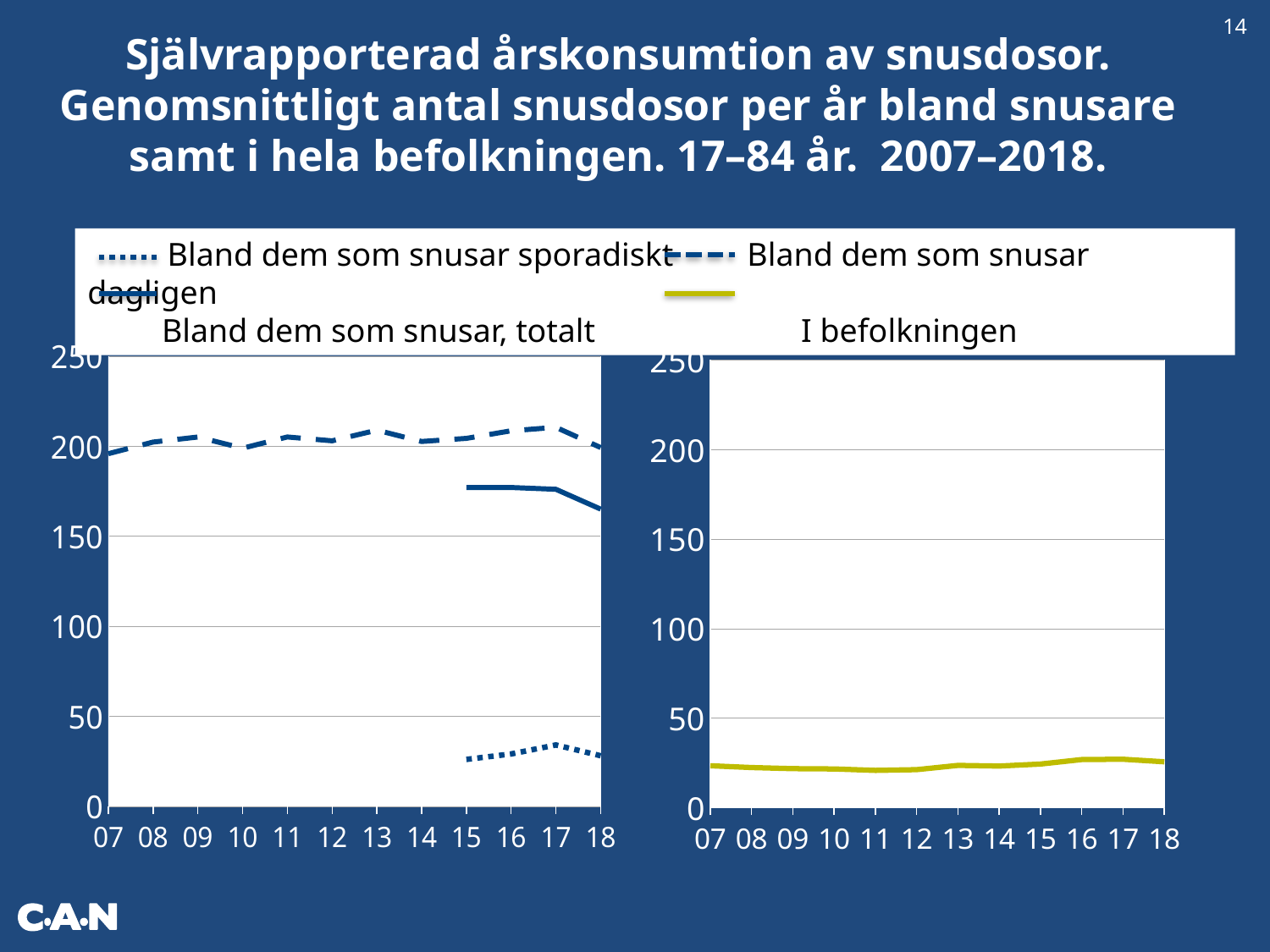
In the left chart "Bland dem som snusar, totalt", is the value for "Bland dem som snusar, totalt" in 18 greater or less than 200? less In the left chart "Bland dem som snusar, totalt", which series has the larger value in 16: "Bland dem som snusar dagligen" or "Bland dem som snusar sporadiskt"? Bland dem som snusar dagligen In the left chart "Bland dem som snusar, totalt", is the value for "Bland dem som snusar dagligen" in 07 greater or less than 150? greater In the left chart "Bland dem som snusar, totalt", is the value for "Bland dem som snusar, totalt" in 15 greater or less than 150? greater What kind of chart is the left chart titled "Bland dem som snusar, totalt"? line chart What is the title of the right chart on the slide? I befolkningen In the left chart "Bland dem som snusar, totalt", does the "Bland dem som snusar, totalt" series rise or fall from 15 to 18? fall How many years are shown on the x axis of the right chart "I befolkningen"? 12 In the left chart "Bland dem som snusar, totalt", which series has the larger value in 18: "Bland dem som snusar dagligen" or "Bland dem som snusar, totalt"? Bland dem som snusar dagligen